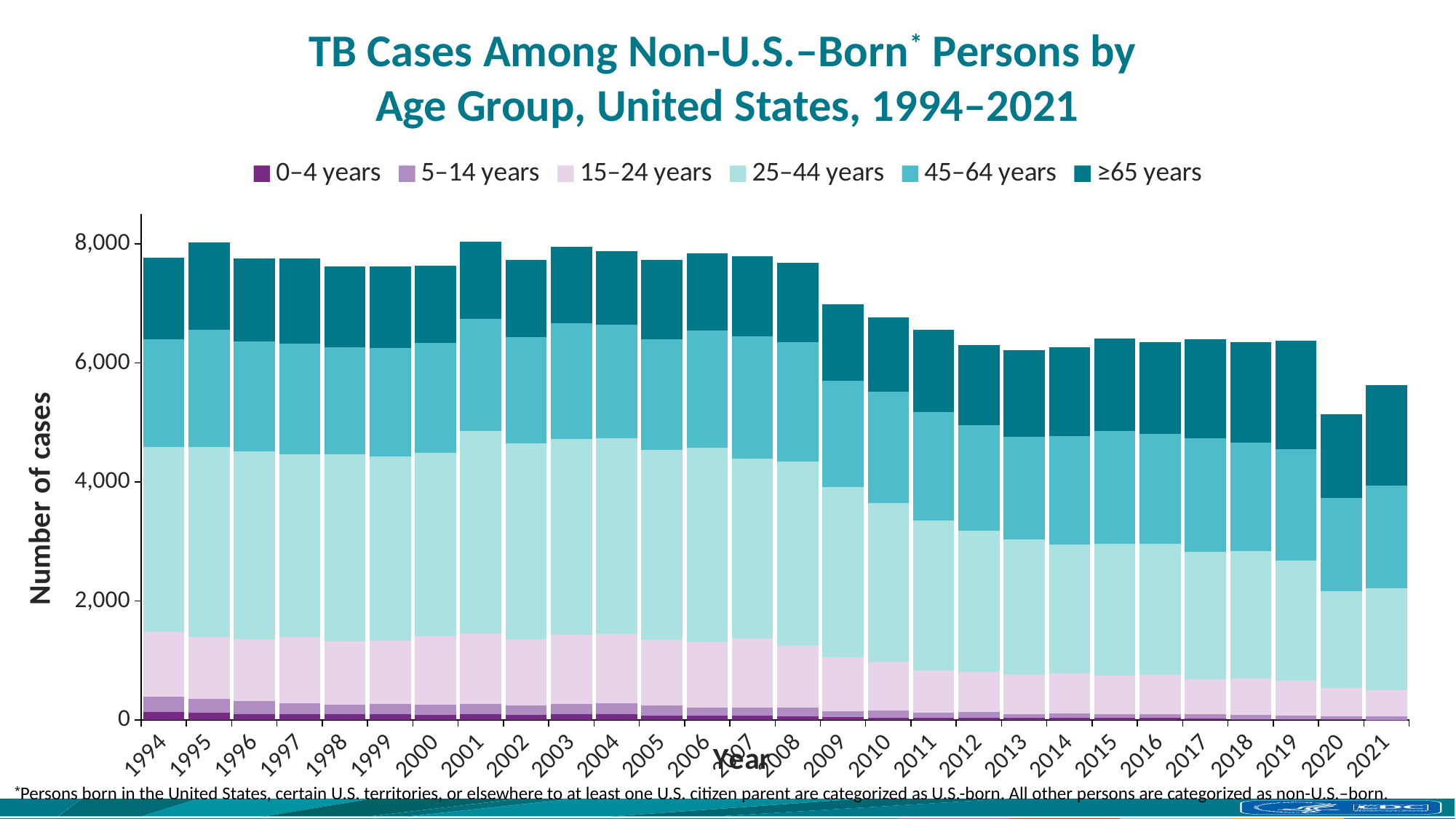
What kind of chart is shown on the slide? Stacked bar chart Which year has the larger total number of cases, 2020 or 2021? 2021 What is the label on the y axis? Number of cases How many years are plotted along the x axis? 28 Overall, do the total number of cases rise or fall from 1994 to 2021? fall Which year has the larger total number of cases, 1994 or 2020? 1994 How many age-group series does the legend list? 6 Which year has the lowest total number of TB cases? 2020 Is the total number of cases for 2021 greater or less than 6,000? less Is the total number of cases for 1994 greater or less than 6,000? greater Is the total number of cases for 2009 greater or less than 6,000? greater